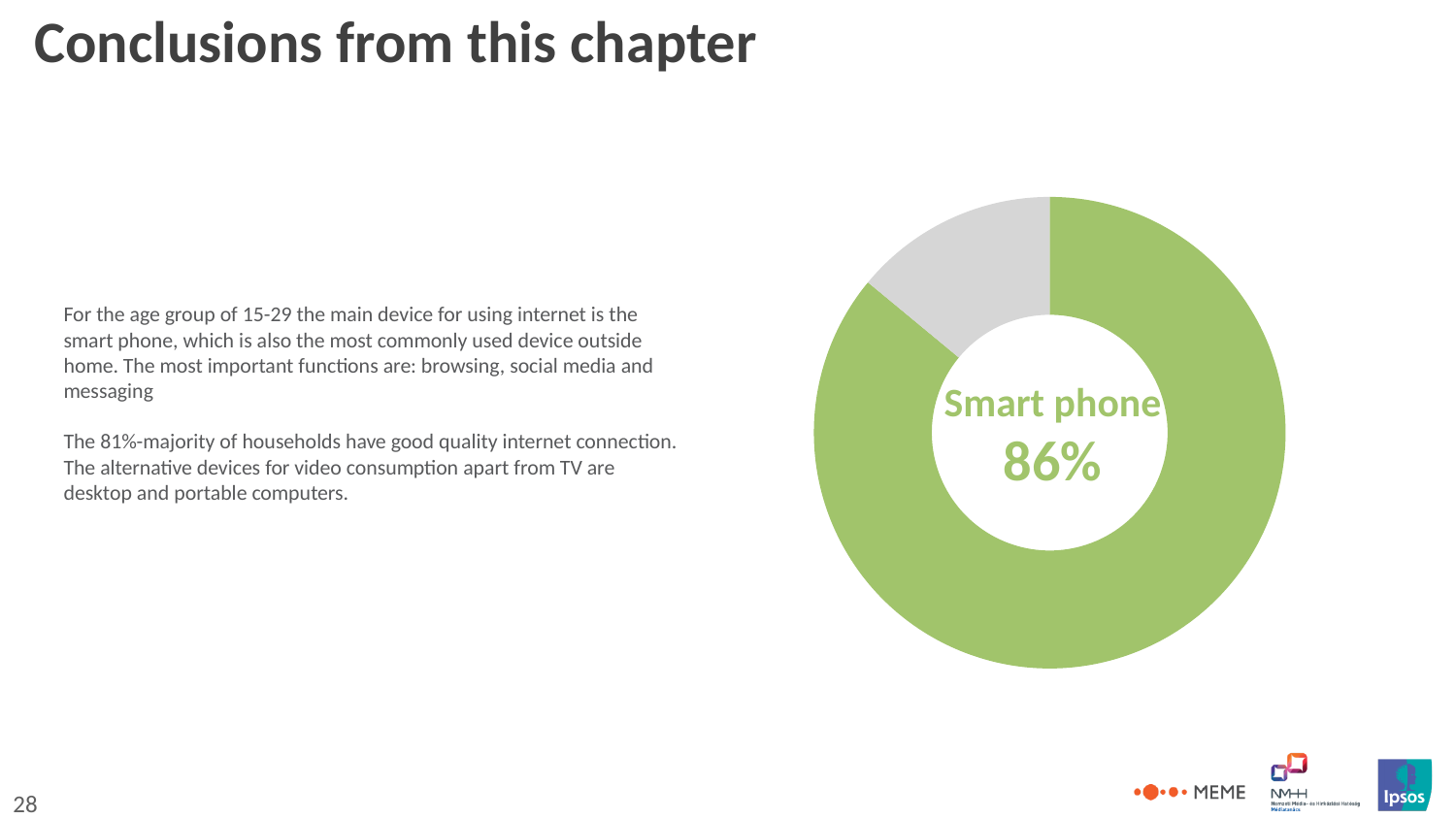
What percentage is shown for Smart phone in the chart? 86% Which category is the largest slice in the doughnut chart? Smart phone What kind of chart is shown on the slide? doughnut chart What colour is the Smart phone slice in the doughnut chart? green Which slice of the doughnut chart is larger, the green one or the grey one? the green one How many slices does the doughnut chart have? 2 What share of the doughnut chart does the Smart phone slice represent? 86% What label is printed in the centre of the doughnut chart? Smart phone 86%